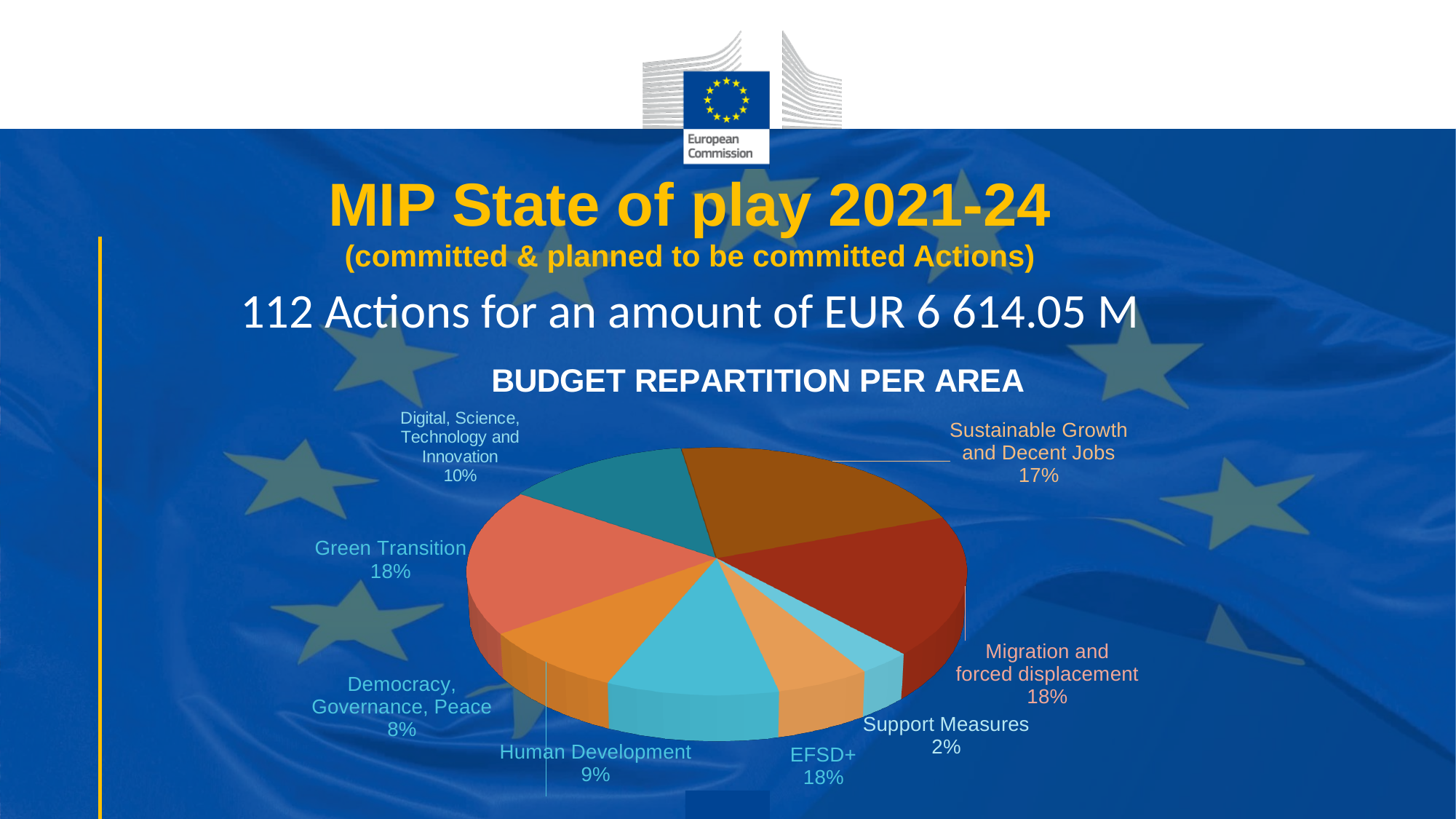
What percentage is shown for Support Measures? 2% Which is larger, the share for Sustainable Growth and Decent Jobs or the share for Democracy, Governance, Peace? Sustainable Growth and Decent Jobs What kind of chart is shown on the slide? pie chart Which area has the smallest share of the budget? Support Measures What percentage is shown for Human Development? 9% What is the title of the chart? BUDGET REPARTITION PER AREA What is the difference in percentage points between Migration and forced displacement and Human Development? 9 What share of the budget goes to Green Transition? 18% What percentage is shown for Digital, Science, Technology and Innovation? 10% How many slices does the pie chart have? 8 What is the difference in percentage points between EFSD+ and Support Measures? 16 What percentage is shown for Sustainable Growth and Decent Jobs? 17%